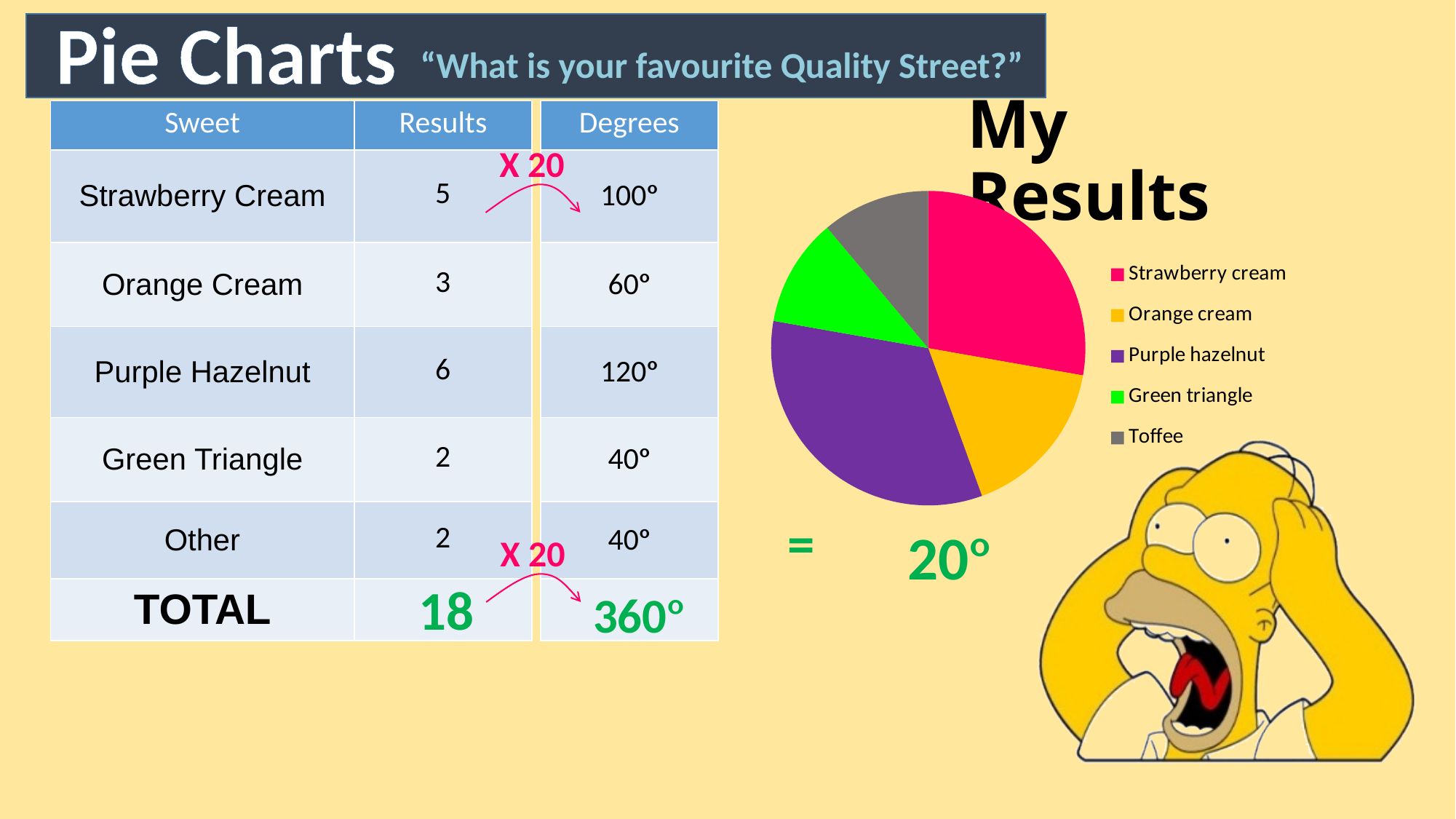
What colour is the Toffee slice in the "My Results" pie chart? grey According to the table, how many results were recorded for Orange Cream? 3 How many slices does the "My Results" pie chart have? 5 Which sweet has the largest slice in the "My Results" pie chart? Purple hazelnut In the "My Results" pie chart, which slice is larger: Strawberry cream or Orange cream? Strawberry cream What is the total number of results in the table? 18 In the "My Results" pie chart, which slice is larger: Purple hazelnut or Green triangle? Purple hazelnut What is the difference in degrees between the Purple Hazelnut slice and the Orange Cream slice, according to the table? 60° What kind of chart is shown under the title "My Results"? pie chart According to the table, how many degrees does the Strawberry Cream slice take up? 100° How many entries does the legend of the "My Results" pie chart list? 5 According to the table, how many degrees does the Purple Hazelnut slice take up? 120°